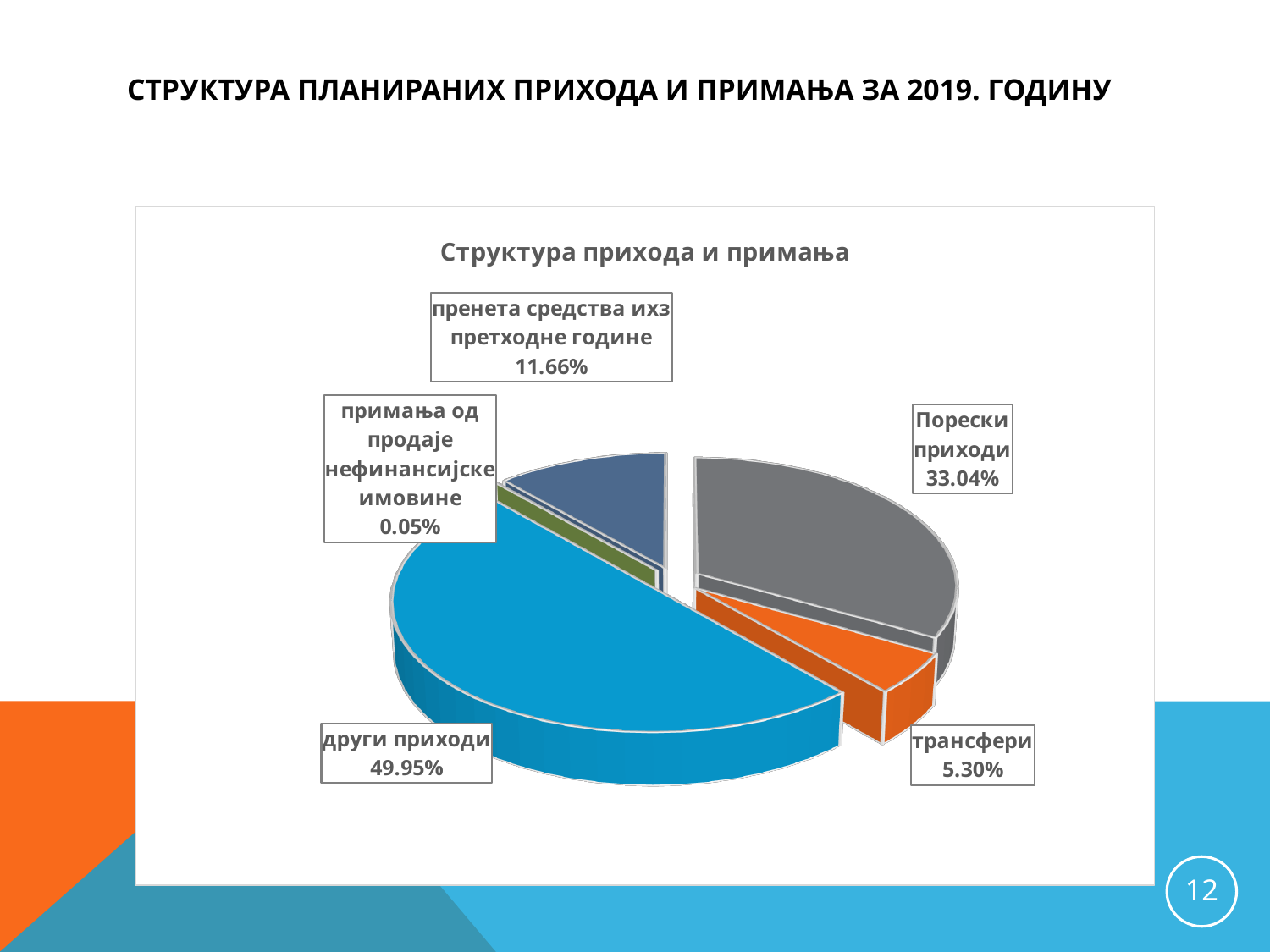
Which category has the largest share of the pie? други приходи What share of the pie is labelled for "пренета средства из претходне године"? 11.66% Which category has the smallest share of the pie? примања од продаје нефинансијске имовине Which is larger, the share for "Порески приходи" or the share for "пренета средства из претходне године"? Порески приходи How many slices does the pie chart have? 5 What share of the pie is labelled for "други приходи"? 49.95% What is the difference in percentage points between the share for "други приходи" and the share for "Порески приходи"? 16.91 What kind of chart is shown on the slide? pie chart What is the title of the chart? Структура прихода и примања What share of the pie is labelled for "Порески приходи"? 33.04% What share of the pie is labelled for "примања од продаје нефинансијске имовине"? 0.05% What share of the pie is labelled for "трансфери"? 5.30%